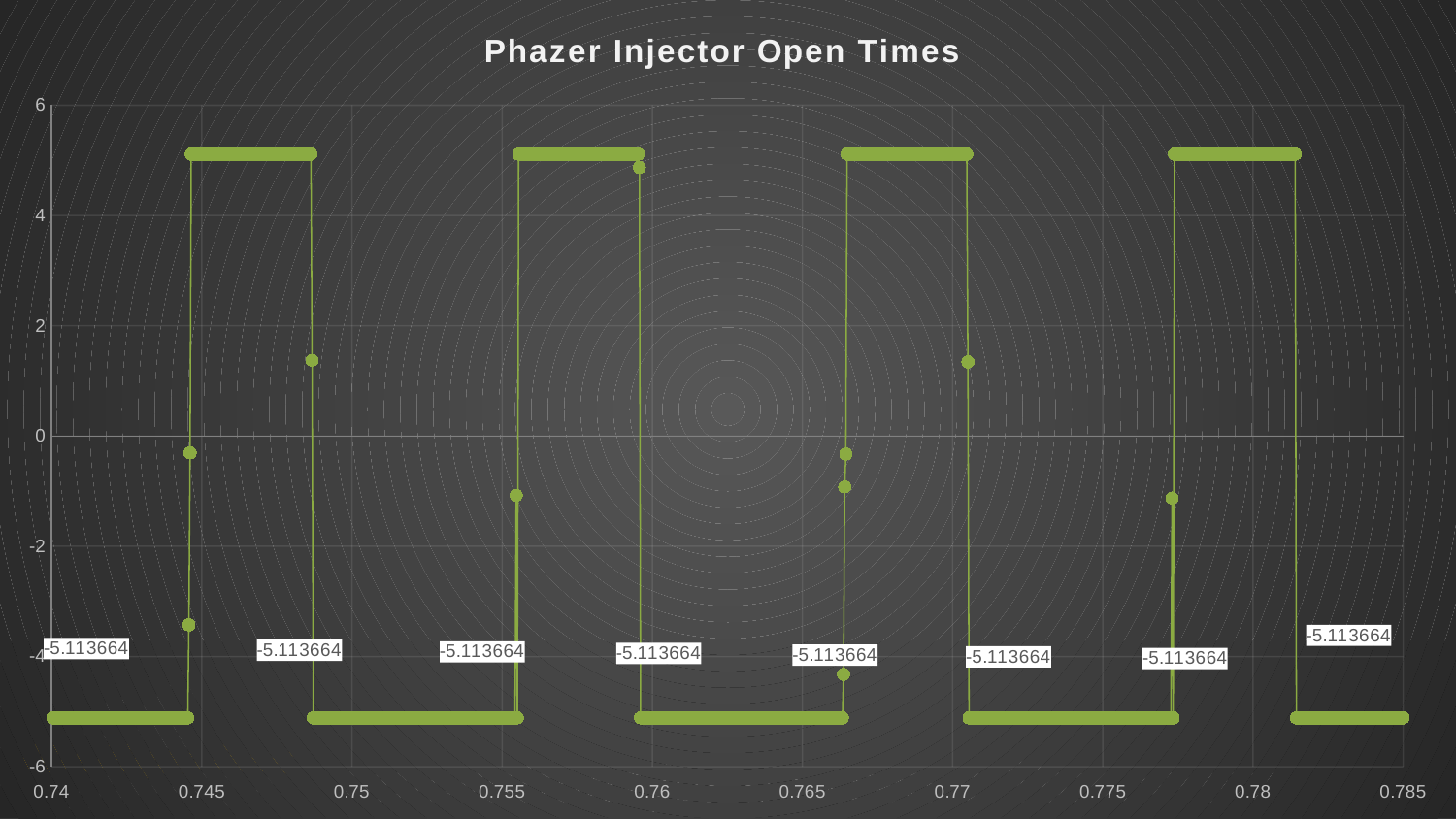
Is the value of the line at x = 0.752 greater or less than -4? less How many high pulses (plateaus near the top of the chart) does the line show between 0.74 and 0.785? 4 Which is larger: the value of the line at x = 0.747 or at x = 0.752? x = 0.747 What kind of chart is shown on the slide? line chart Is the value of the line at x = 0.747 greater or less than 4? greater How many data labels reading -5.113664 are printed on the chart? 8 Is the value of the line at x = 0.7625 greater or less than 0? less What is the highest value shown on the vertical axis? 6 What value is printed on the data labels along the low plateaus of the line? -5.113664 What is the title of the chart? Phazer Injector Open Times